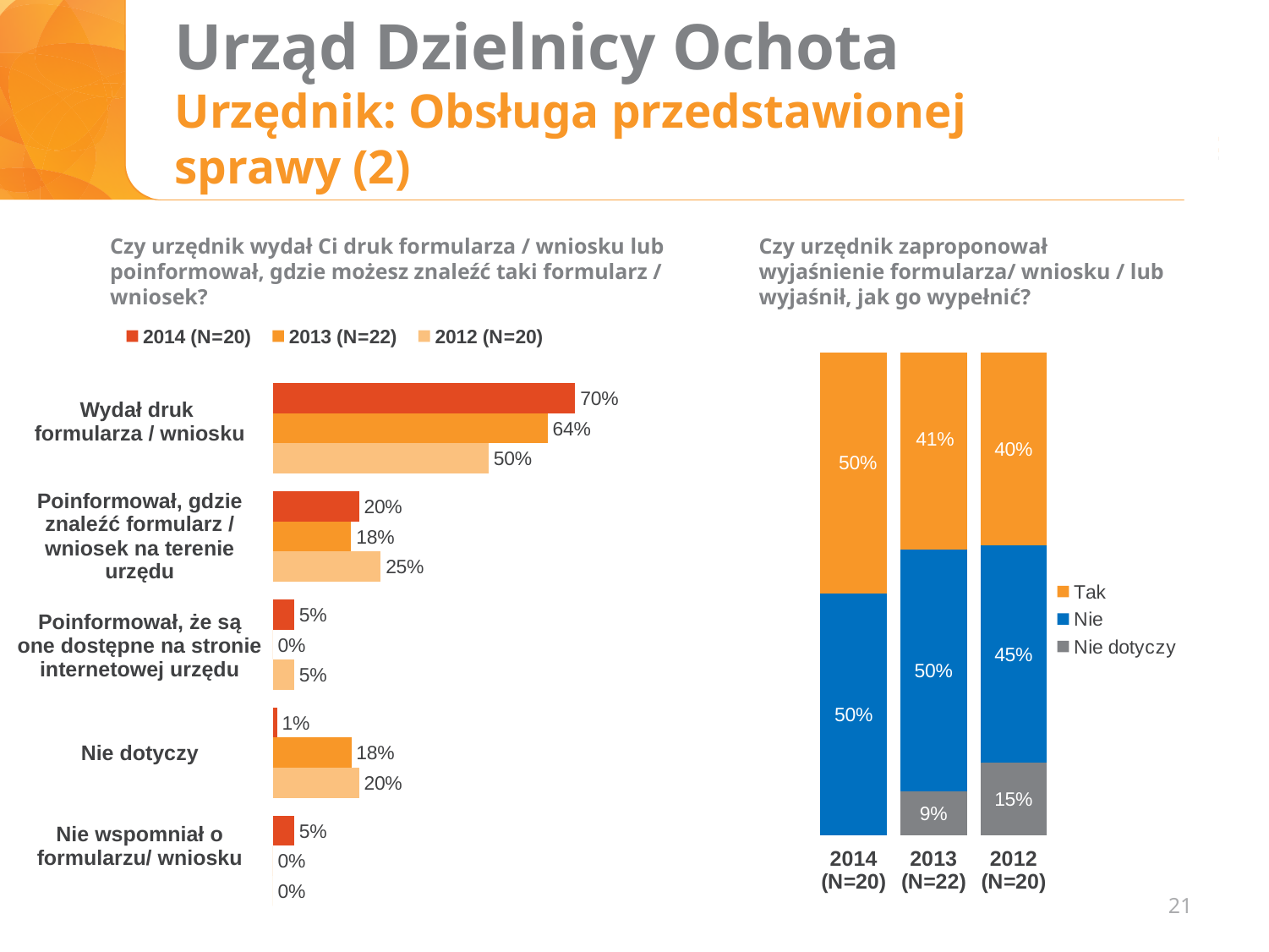
In the left chart, which category has the highest value for 2014 (N=20)? Wydał druk formularza / wniosku In the right chart, which year has the highest "Tak" share? 2014 (N=20) What kind of chart is the left chart? Bar chart In the right chart, which series is shown in grey? Nie dotyczy In the left chart, what is the value for "Poinformował, gdzie znaleźć formularz / wniosek na terenie urzędu" in 2012 (N=20)? 25% In the left chart, what is the difference between the 2014 and 2012 values for "Wydał druk formularza / wniosku"? 20% In the left chart ("Czy urzędnik wydał Ci druk formularza / wniosku..."), what is the value for "Wydał druk formularza / wniosku" in 2014 (N=20)? 70% In the left chart, what is the value for "Nie dotyczy" in 2013 (N=22)? 18% In the left chart, how many series does the legend list? 3 In the left chart, how many categories are shown? 5 In the right chart, what is the "Nie dotyczy" share for 2013 (N=22)? 9% In the right chart ("Czy urzędnik zaproponował wyjaśnienie formularza..."), what is the "Nie" share for 2012 (N=20)? 45%